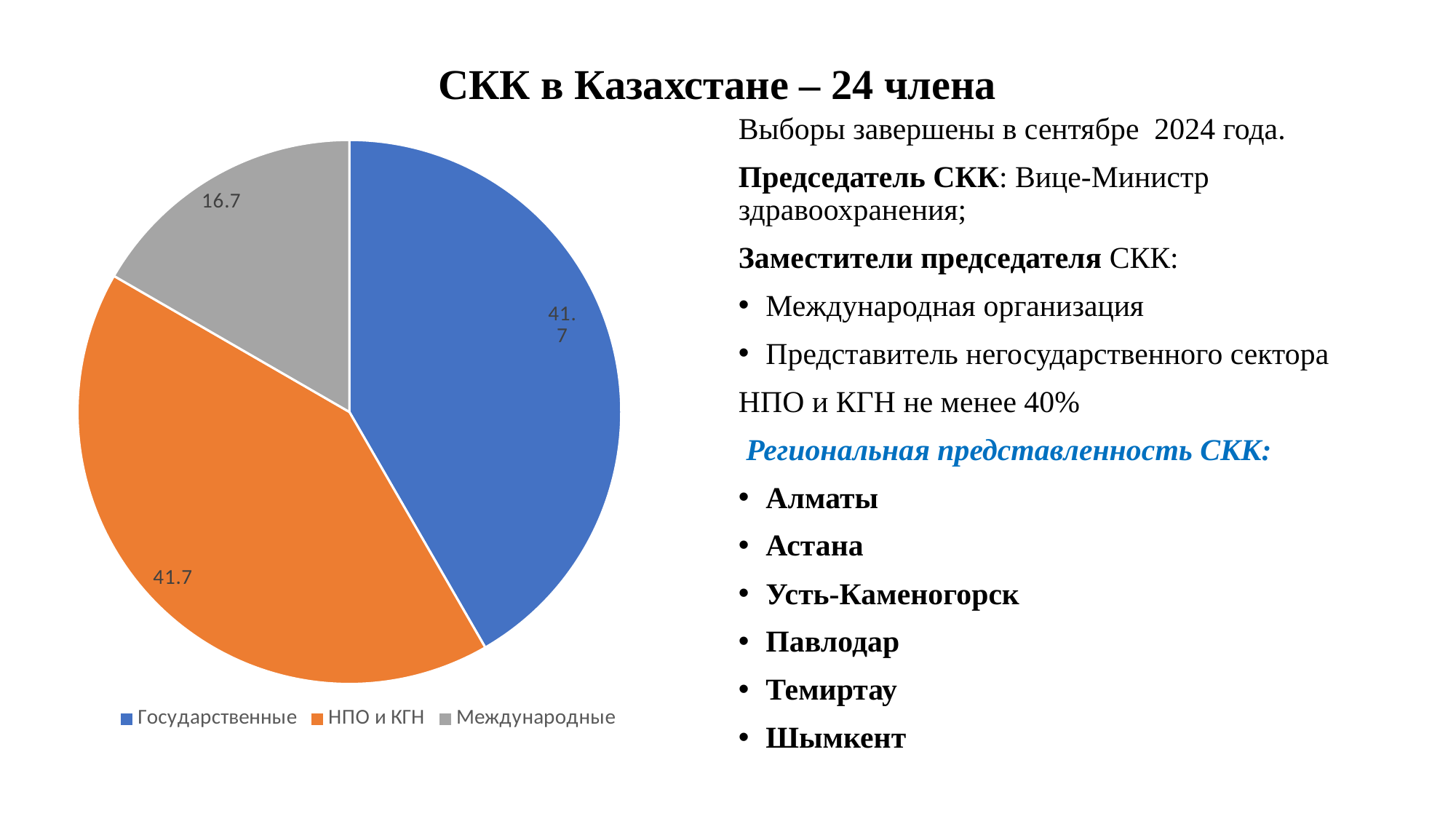
Which is larger, the value for Государственные or the value for Международные? Государственные What kind of chart is shown on the slide? pie chart What is the value shown for the Международные slice? 16.7 Which category has the smallest slice of the pie? Международные What colour is the НПО и КГН slice? orange What is the value shown for the НПО и КГН slice? 41.7 What is the difference between the value for НПО и КГН and the value for Международные? 25 What colour is the Международные slice? grey Are the values for Государственные and НПО и КГН equal? yes How many entries does the legend list? 3 What is the value shown for the Государственные slice? 41.7 How many slices does the pie chart have? 3